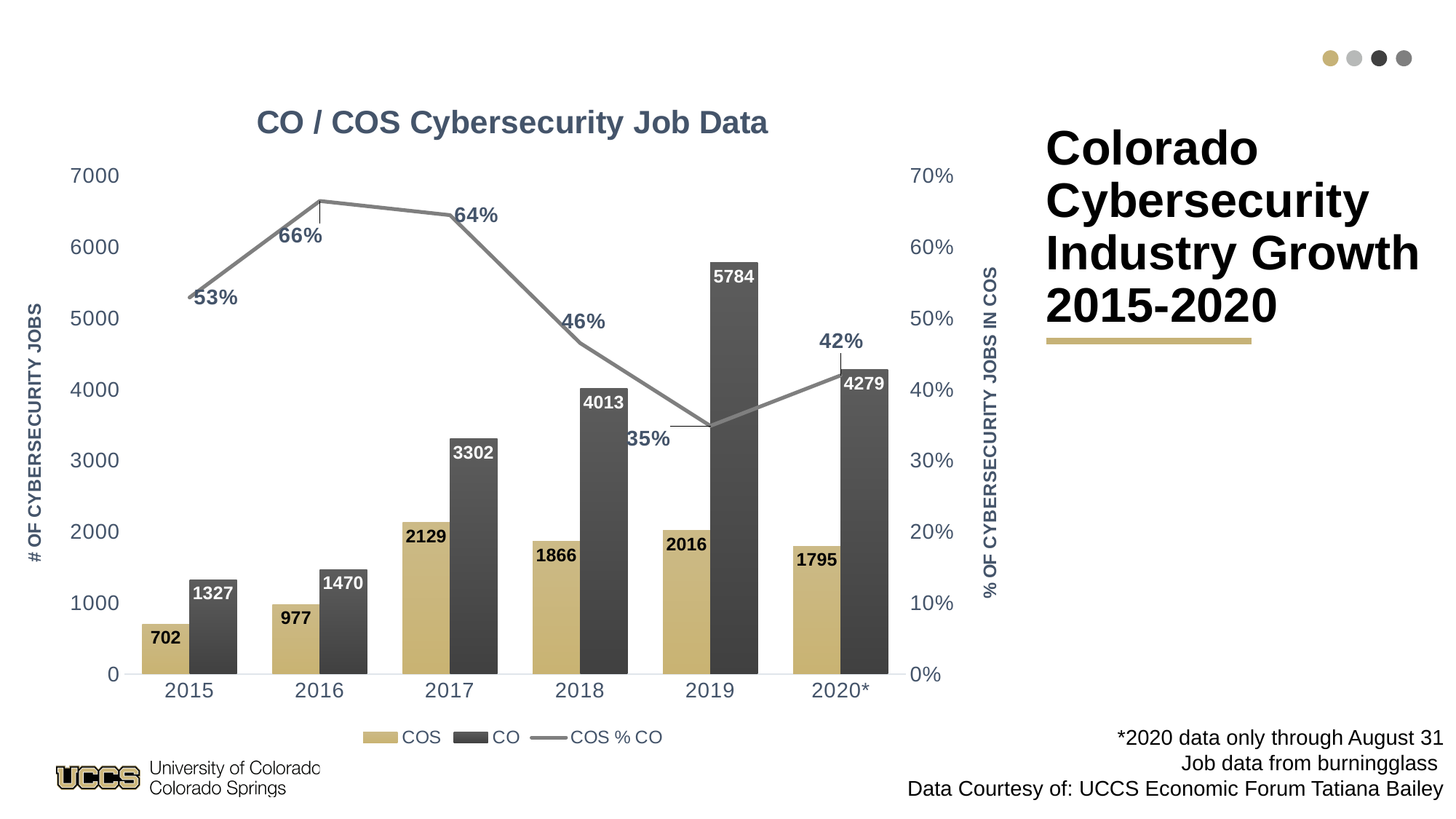
How many years are shown on the x axis? 6 What is the value for COS in 2017? 2129 Which year has the lowest COS value? 2015 Is the CO value for 2020* greater or less than 4000? greater What is the value for CO in 2019? 5784 What is the COS % CO value for 2016? 66% Which is larger, the COS value in 2017 or the COS value in 2019? COS value in 2017 How many series does the legend list? 3 Which year has the highest CO value? 2019 What is the difference between the CO and COS values in 2018? 2147 Does the COS % CO line rise or fall from 2017 to 2019? fall What is the title of the chart? CO / COS Cybersecurity Job Data